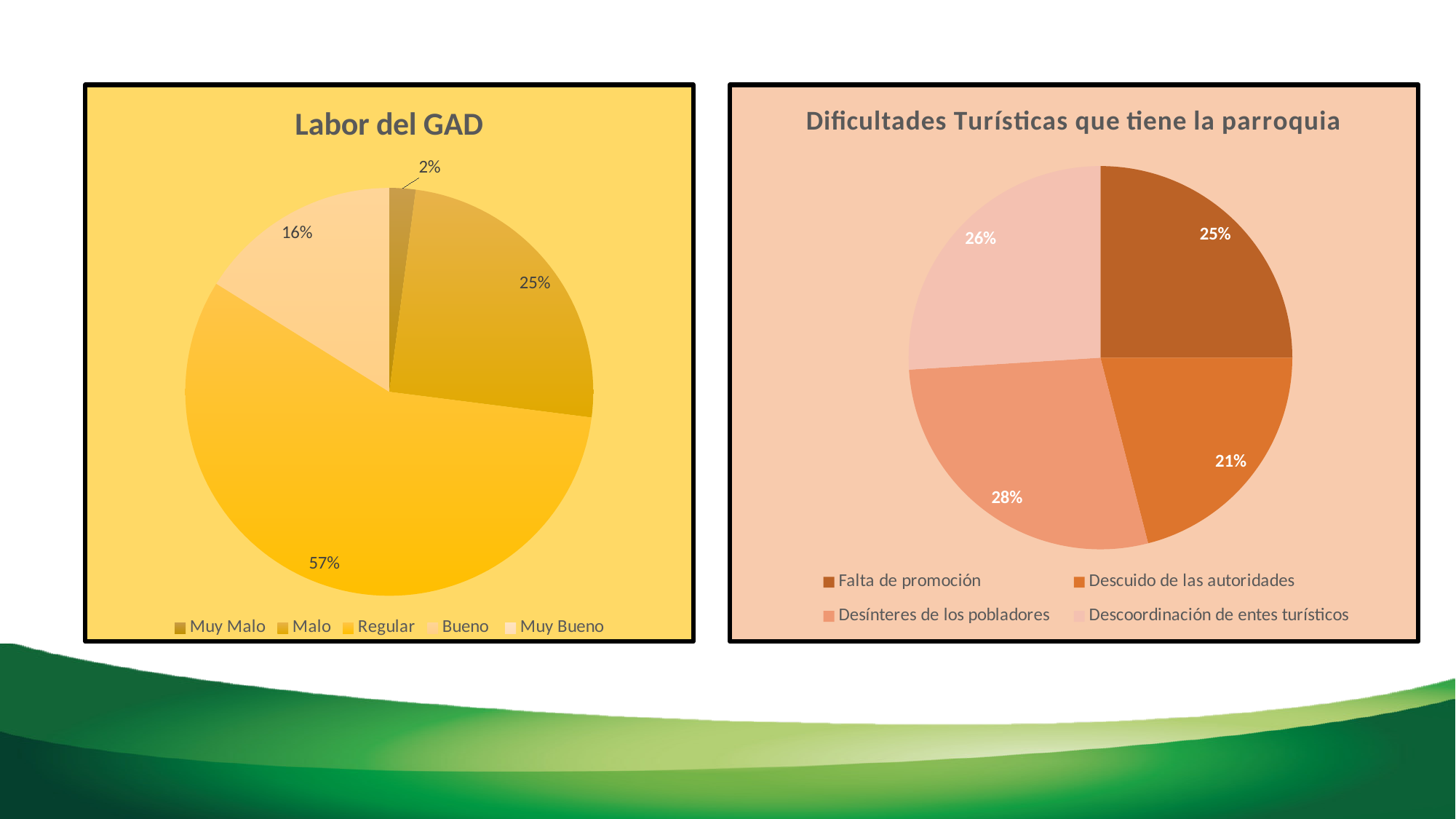
In the 'Labor del GAD' chart, which category has the largest slice? Regular In the 'Dificultades Turísticas que tiene la parroquia' chart, how many categories are shown in the legend? 4 In the 'Dificultades Turísticas que tiene la parroquia' chart, which is larger: Falta de promoción or Descoordinación de entes turísticos? Descoordinación de entes turísticos In the 'Labor del GAD' chart, how many entries does the legend list? 5 In the 'Dificultades Turísticas que tiene la parroquia' chart, what share does Descuido de las autoridades have? 21% In the 'Dificultades Turísticas que tiene la parroquia' chart, what share does Desínteres de los pobladores have? 28% In the 'Labor del GAD' chart, what share does Malo have? 25% In the 'Dificultades Turísticas que tiene la parroquia' chart, which category has the smallest slice? Descuido de las autoridades In the 'Labor del GAD' chart, what share does Bueno have? 16% What kind of chart is 'Labor del GAD'? Pie chart In the 'Labor del GAD' chart, what is the difference between the Malo and Bueno shares? 9% In the 'Labor del GAD' chart, what share does Regular have? 57%